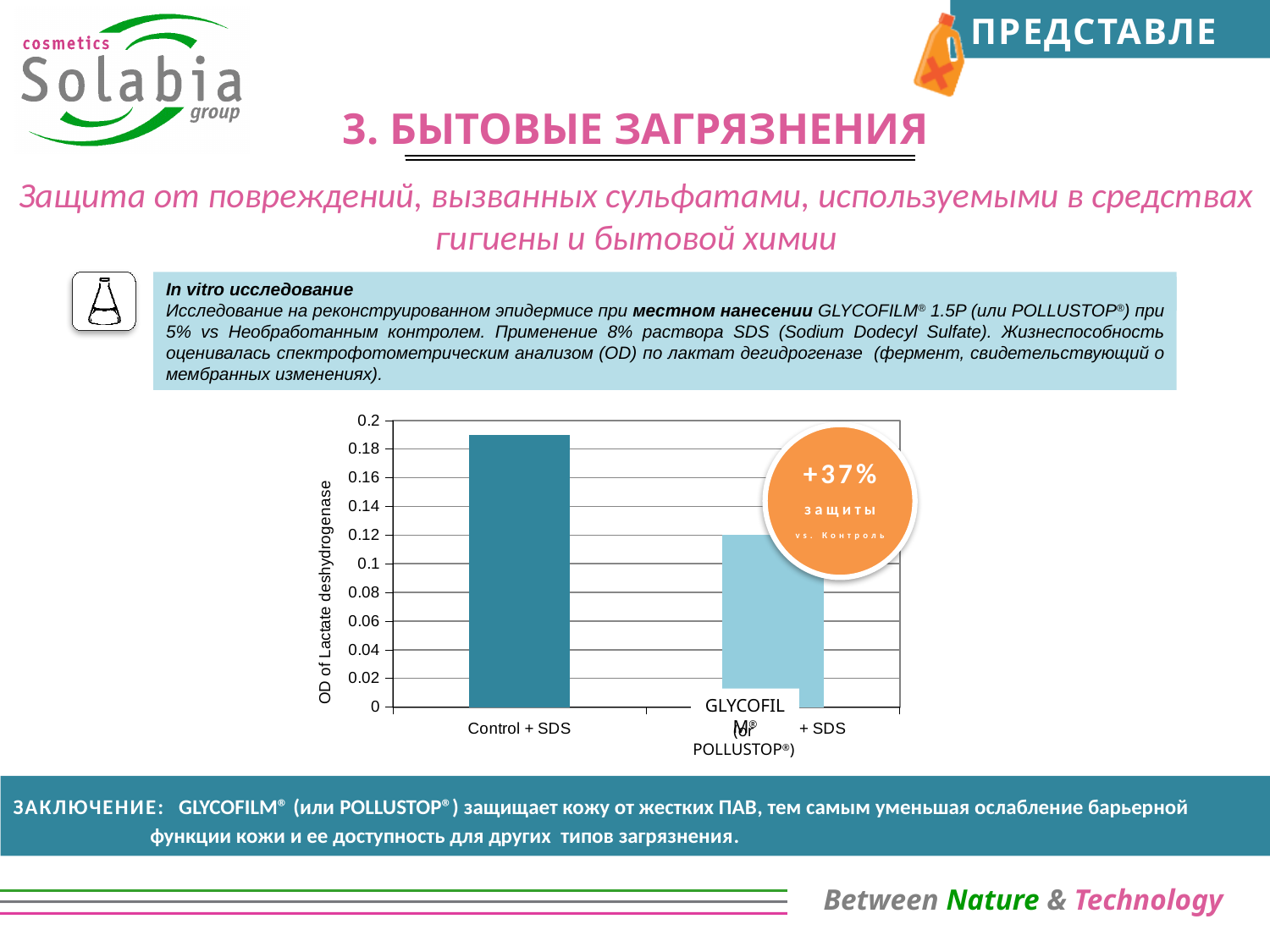
Which category has the highest bar in the chart? Control + SDS What is the label of the y axis of the chart? OD of Lactate deshydrogenase What kind of chart is shown on the slide? bar chart Is the value for GLYCOFILM® (or POLLUSTOP®) + SDS greater or less than 0.1? greater Is the value for GLYCOFILM® (or POLLUSTOP®) + SDS greater or less than 0.14? less How many bars are plotted in the chart? 2 What percentage of protection vs. control is stated in the circle annotation on the chart? +37% Is the value for Control + SDS greater or less than 0.2? less Which category has the lowest bar in the chart? GLYCOFILM® (or POLLUSTOP®) + SDS Which bar is taller: Control + SDS or GLYCOFILM® (or POLLUSTOP®) + SDS? Control + SDS